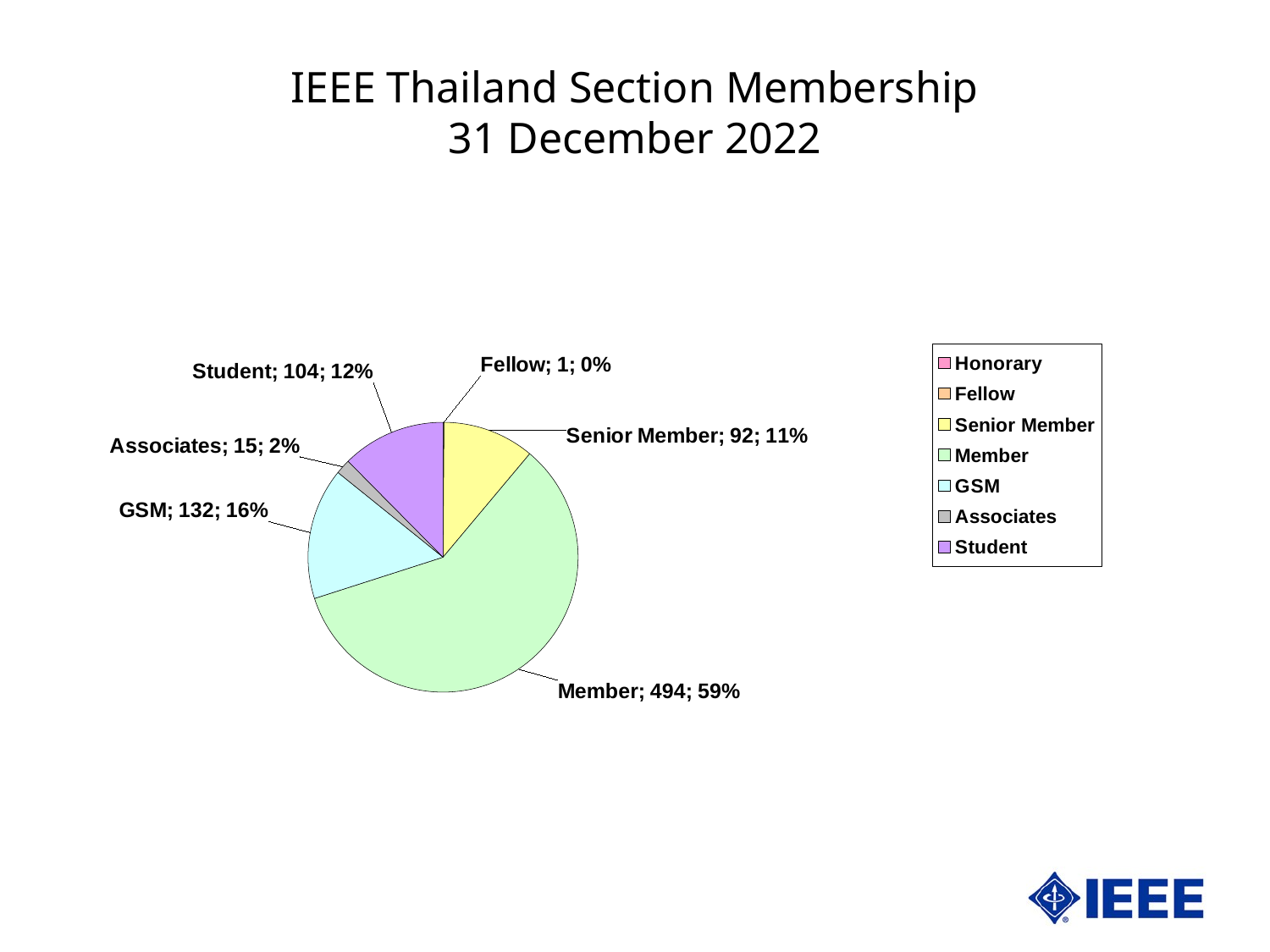
What share of the pie does the Member slice represent? 59% Which is larger, the value for Senior Member or the value for Student? Student What is the value for Senior Member? 92 What is the difference between the GSM value and the Student value? 28 Which category has the largest slice? Member What kind of chart is shown on the slide? pie chart What is the value for GSM? 132 How many members are in the Member category? 494 Which labelled category has the smallest value? Fellow How many entries does the legend list? 7 What share of the pie does the Student slice represent? 12% What is the title of the slide? IEEE Thailand Section Membership 31 December 2022